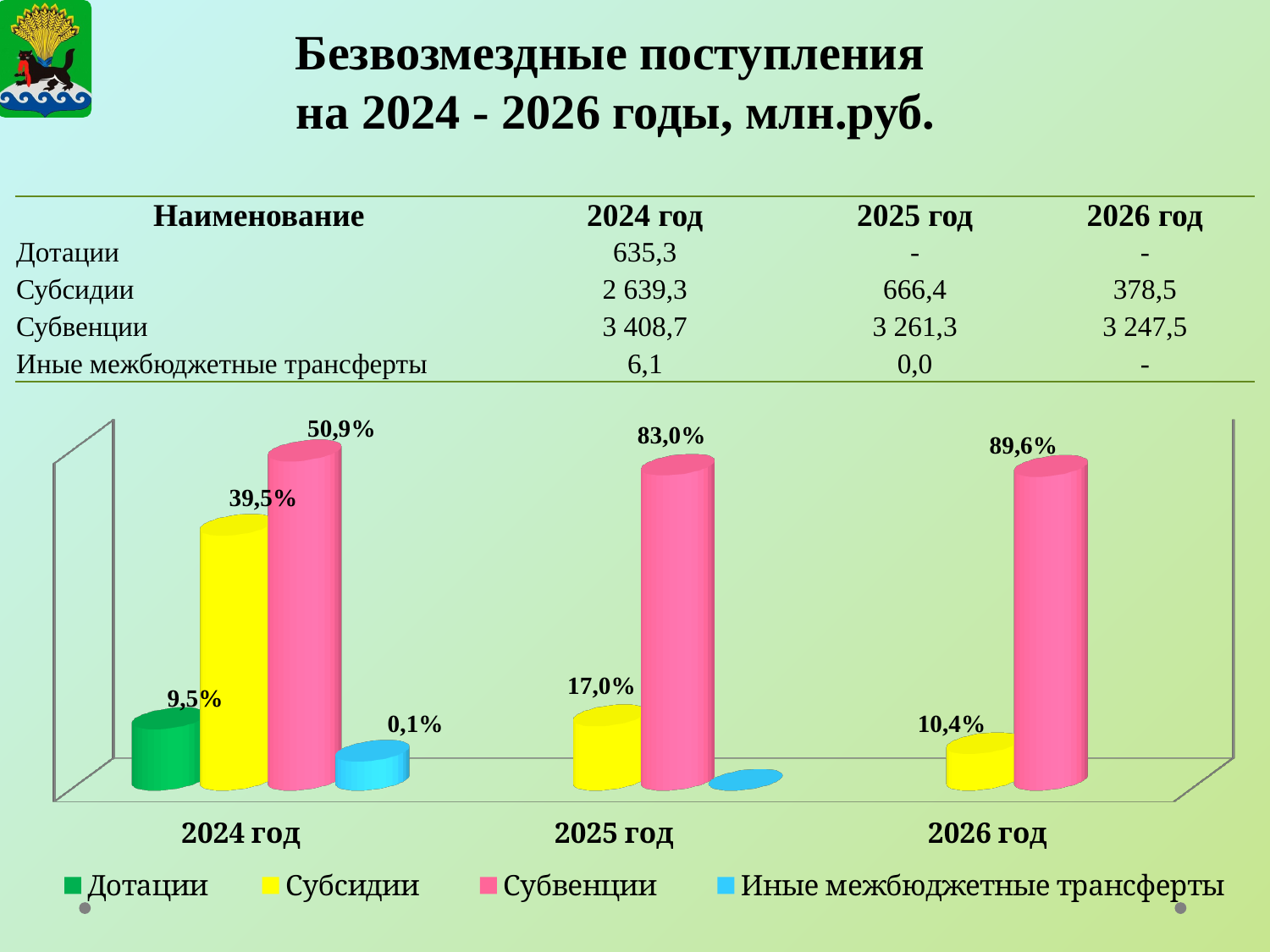
What is the value for Иные межбюджетные трансферты in 2024 год? 0,1% What kind of chart is shown on the slide? Bar chart How many years are shown on the x axis of the chart? 3 How many series does the chart legend list? 4 In which year is the value for Субсидии lowest? 2026 год What is the value for Дотации in 2024 год? 9,5% What is the difference between Субвенции and Субсидии in 2026 год? 79,2% Which is larger in 2024 год: Субсидии or Субвенции? Субвенции What is the value for Субсидии in 2025 год? 17,0% What is the value for Субвенции in 2024 год? 50,9%